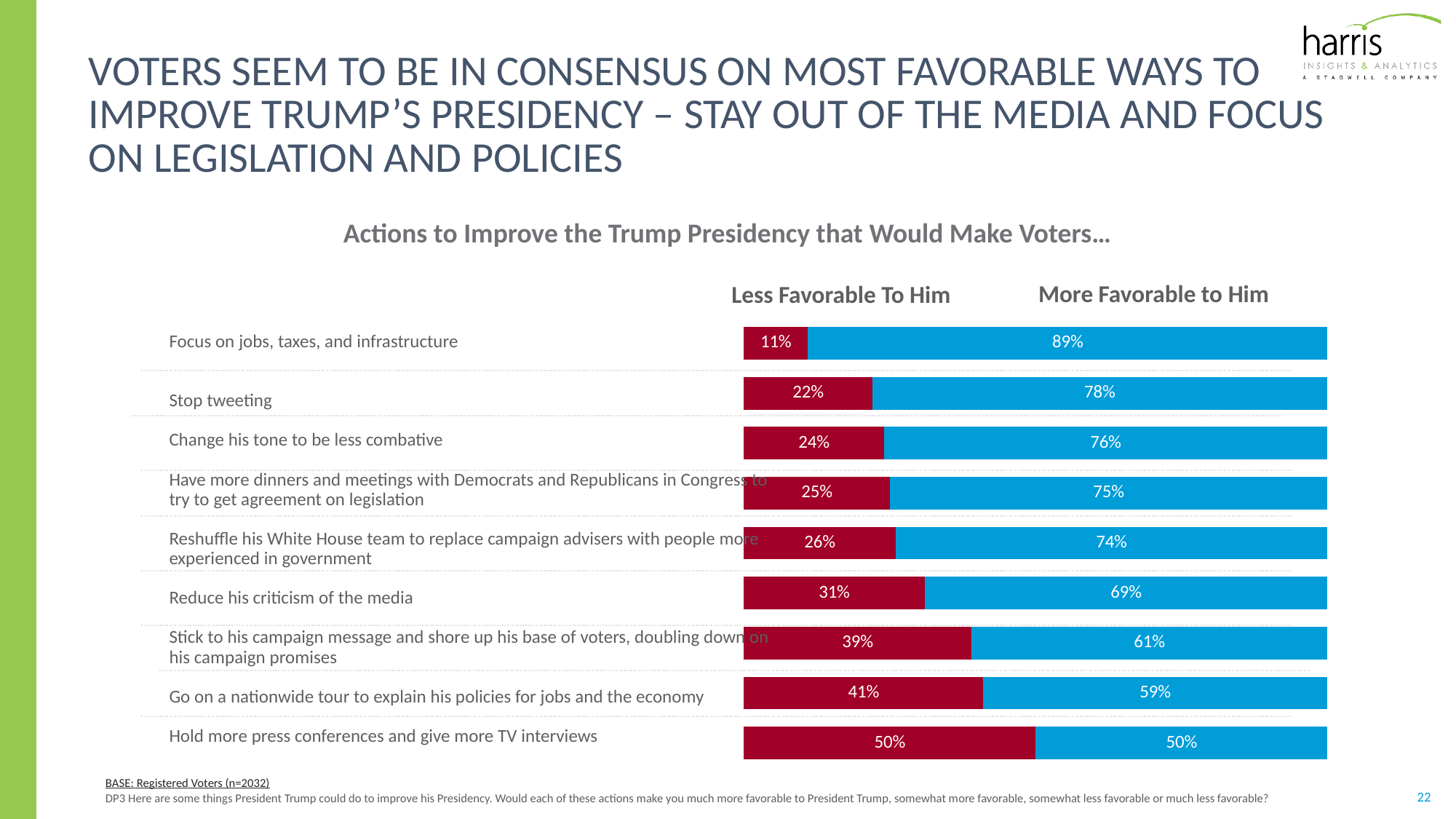
How many series does the chart show? 2 How many actions are listed in the chart? 9 What percentage of voters say focusing on jobs, taxes, and infrastructure would make them more favorable to him? 89% What is the title of the chart? Actions to Improve the Trump Presidency that Would Make Voters... Which action has the lowest 'More Favorable to Him' percentage? Hold more press conferences and give more TV interviews What type of chart is shown on the slide? Stacked bar chart What is the 'More Favorable to Him' value for 'Reduce his criticism of the media'? 69% What is the total of the two values for 'Hold more press conferences and give more TV interviews'? 100% What is the 'Less Favorable To Him' value for 'Stop tweeting'? 22% What is the difference between the 'More Favorable to Him' values for 'Stop tweeting' and 'Go on a nationwide tour to explain his policies for jobs and the economy'? 19 percentage points Which has a larger 'Less Favorable To Him' value: 'Change his tone to be less combative' or 'Reduce his criticism of the media'? Reduce his criticism of the media Which action has the highest 'More Favorable to Him' percentage? Focus on jobs, taxes, and infrastructure